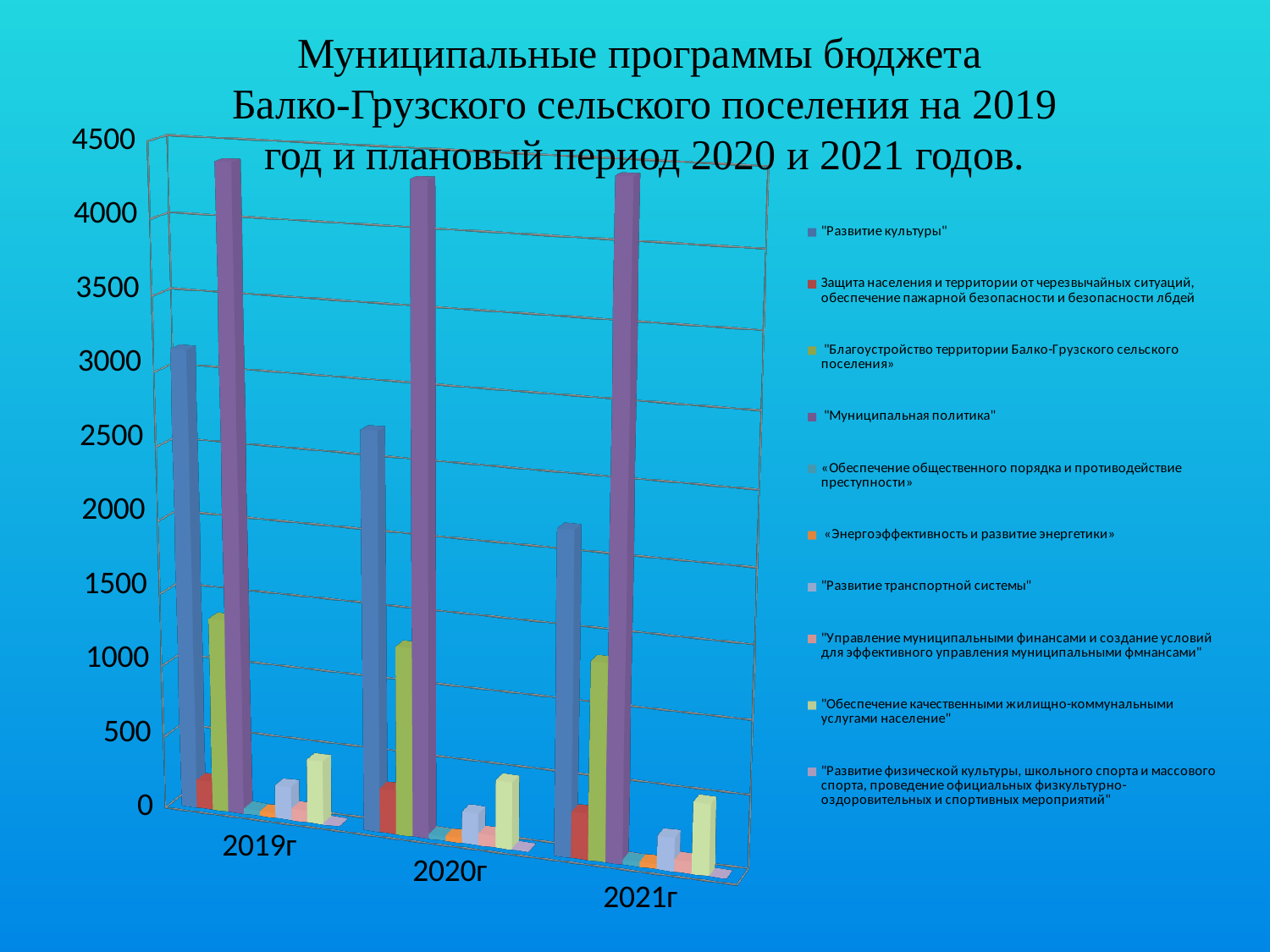
Does the value for "Развитие культуры" rise or fall from 2019г to 2021г? Fall Which series has the highest value in 2019г? "Муниципальная политика" Which series has the highest value in 2021г? "Муниципальная политика" Is the value for "Благоустройство территории Балко-Грузского сельского поселения" in 2019г greater or less than 1000? greater Which is larger in 2019г: "Развитие культуры" or "Благоустройство территории Балко-Грузского сельского поселения"? "Развитие культуры" Is the value for "Развитие культуры" in 2019г greater or less than 2500? greater In which year is the value for "Развитие культуры" the highest? 2019г How many year categories are shown on the x axis of the chart? 3 What kind of chart is shown on the slide? Bar chart Is the value for "Муниципальная политика" in 2019г greater or less than 4000? greater How many series does the chart's legend list? 10